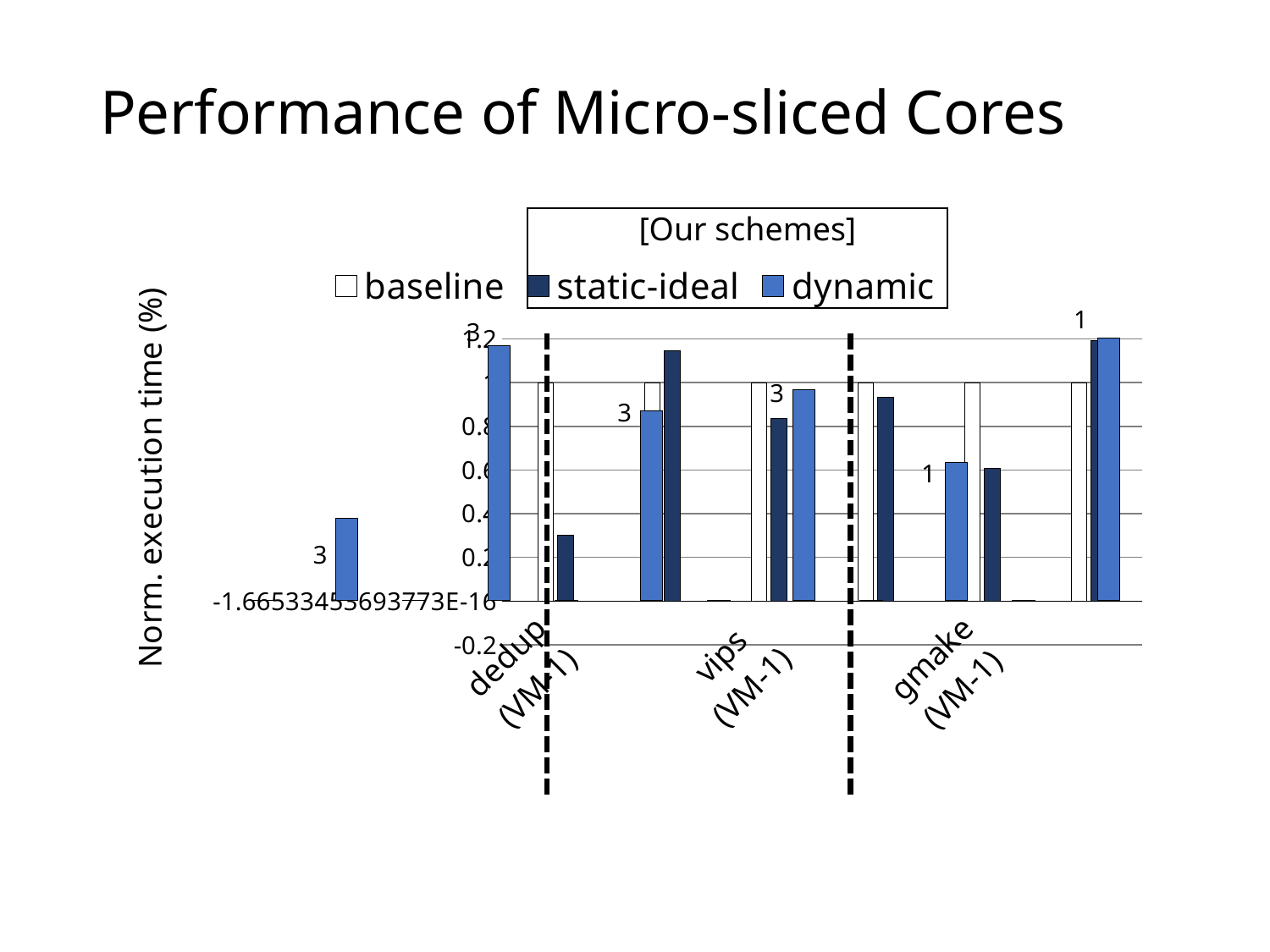
How many benchmark labels are readable on the chart's x axis? 3 What kind of chart is shown on the slide? bar chart How many series does the chart legend list? 3 Which benchmark label appears between dedup (VM-1) and gmake (VM-1) on the x axis? vips (VM-1) What is the label on the chart's vertical axis? Norm. execution time (%) What are the three series named in the chart legend? baseline, static-ideal, dynamic